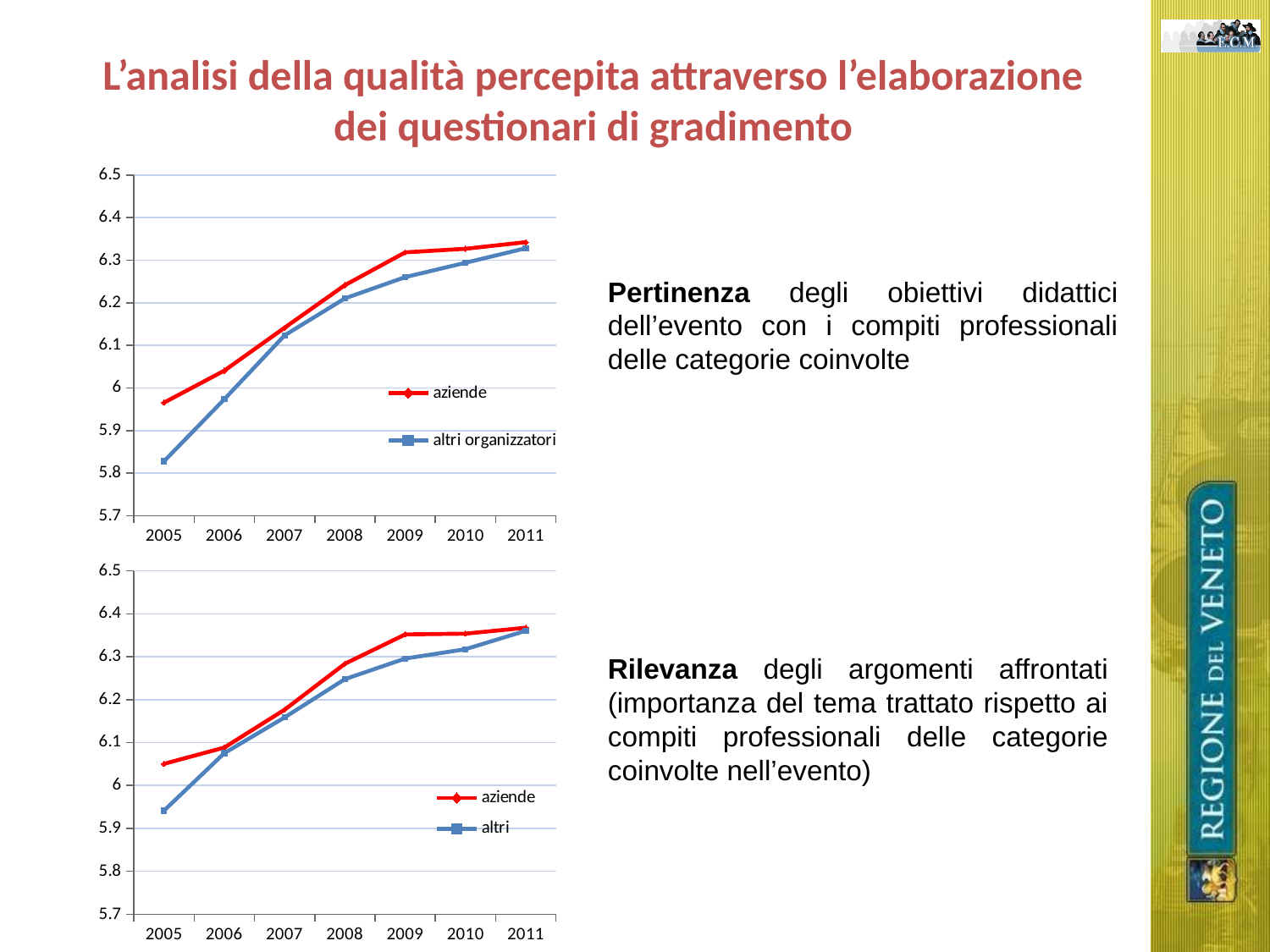
In the bottom chart, is the value for altri in 2005 greater or less than 6? less In the top chart, do the values for aziende rise or fall from 2005 to 2011? rise In the top chart, is the value for altri organizzatori in 2005 greater or less than 5.9? less In the top chart, in which year is the value for aziende lowest? 2005 What are the two series named in the legend of the bottom chart? aziende and altri In the top chart, is the value for aziende in 2011 greater or less than 6.3? greater What kind of chart is the top chart on the slide? line chart In the top chart, which series has the higher value in 2005, aziende or altri organizzatori? aziende How many years are shown on the x axis of the top chart? 7 How many series does the legend of the top chart list? 2 In the bottom chart, in which year is the value for altri highest? 2011